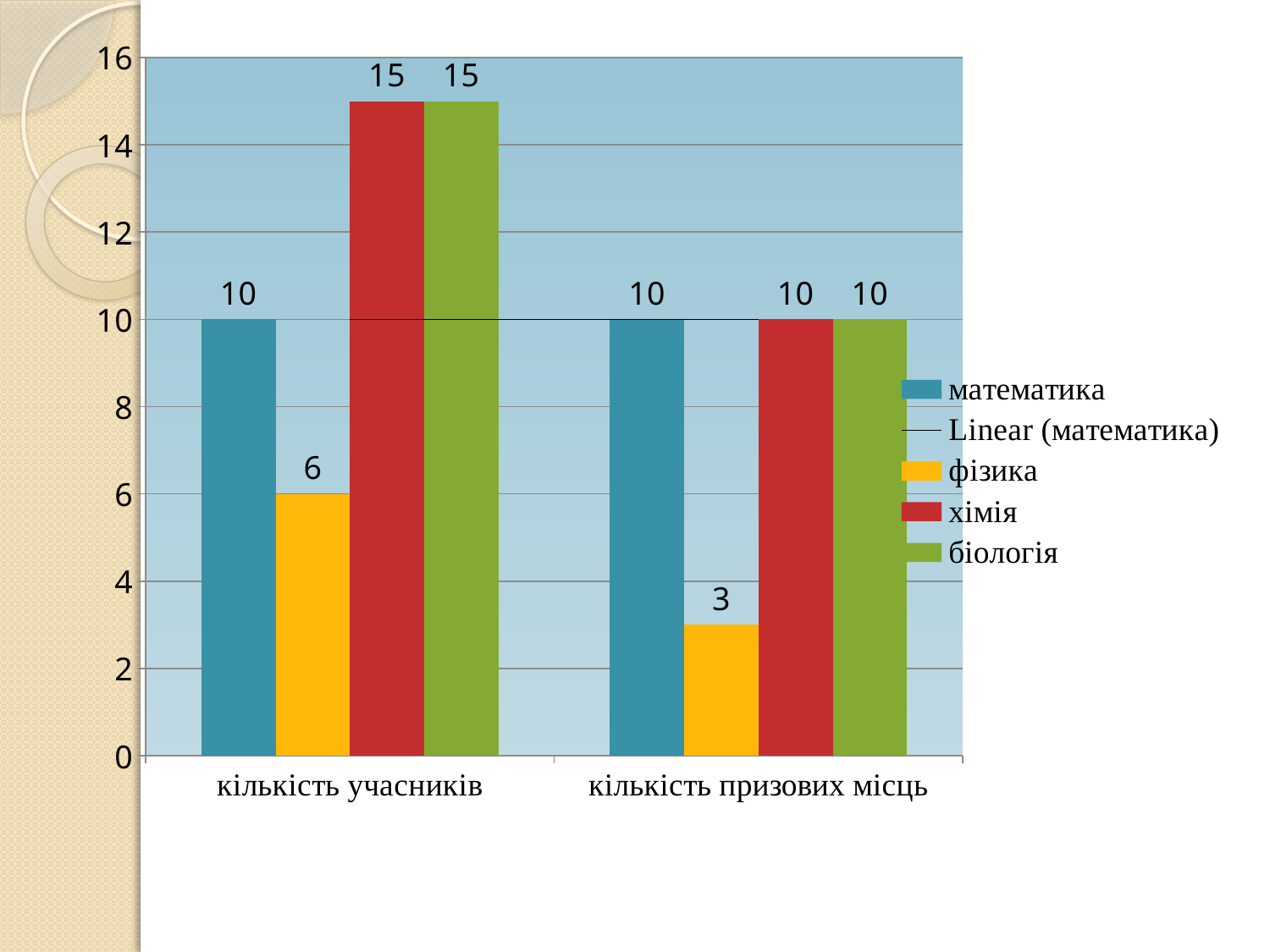
What is the value for хімія in the кількість призових місць category? 10 How many entries does the legend list? 5 Which is larger in the кількість учасників category: математика or хімія? хімія What is the value for біологія in the кількість учасників category? 15 What is the difference between the фізика values for кількість учасників and кількість призових місць? 3 What is the difference between the хімія and фізика values in the кількість учасників category? 9 How many categories are shown on the x axis? 2 What is the value for фізика in the кількість призових місць category? 3 Which series has the lowest value in the кількість учасників category? фізика Which series has the lowest value in the кількість призових місць category? фізика What is the value for фізика in the кількість учасників category? 6 What kind of chart is shown on the slide? bar chart